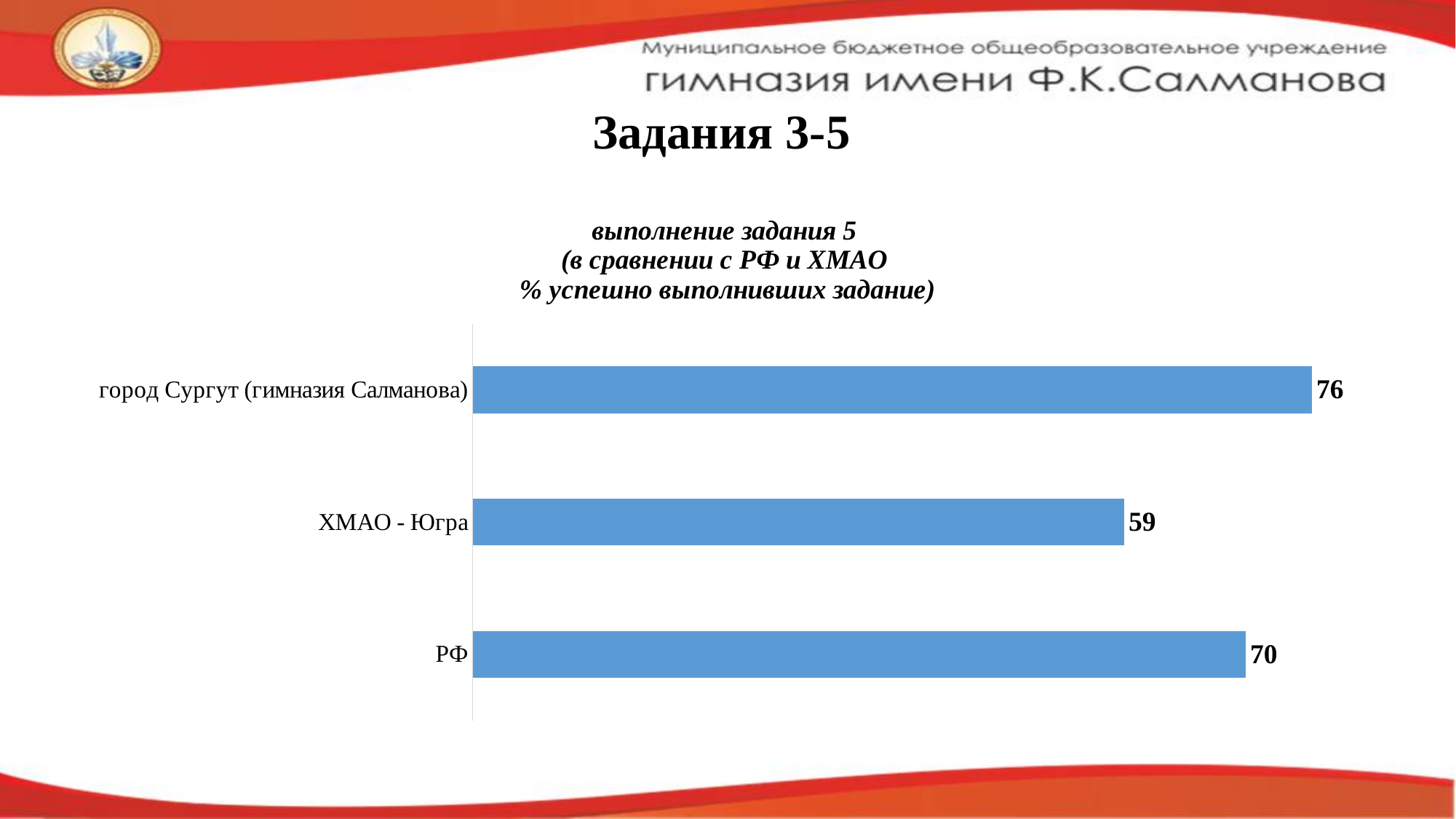
Which is larger, the value for РФ or the value for ХМАО - Югра? РФ What is the title of the chart? выполнение задания 5 (в сравнении с РФ и ХМАО % успешно выполнивших задание) Which category has the highest value? город Сургут (гимназия Салманова) Which category has the lowest value? ХМАО - Югра What is the difference between the values for РФ and ХМАО - Югра? 11 What is the value for город Сургут (гимназия Салманова)? 76 What is the difference between the values for город Сургут (гимназия Салманова) and РФ? 6 What is the value for ХМАО - Югра? 59 What is the value for РФ? 70 What colour are the bars in the chart? blue What kind of chart is shown on the slide? bar chart How many categories are shown in the chart? 3